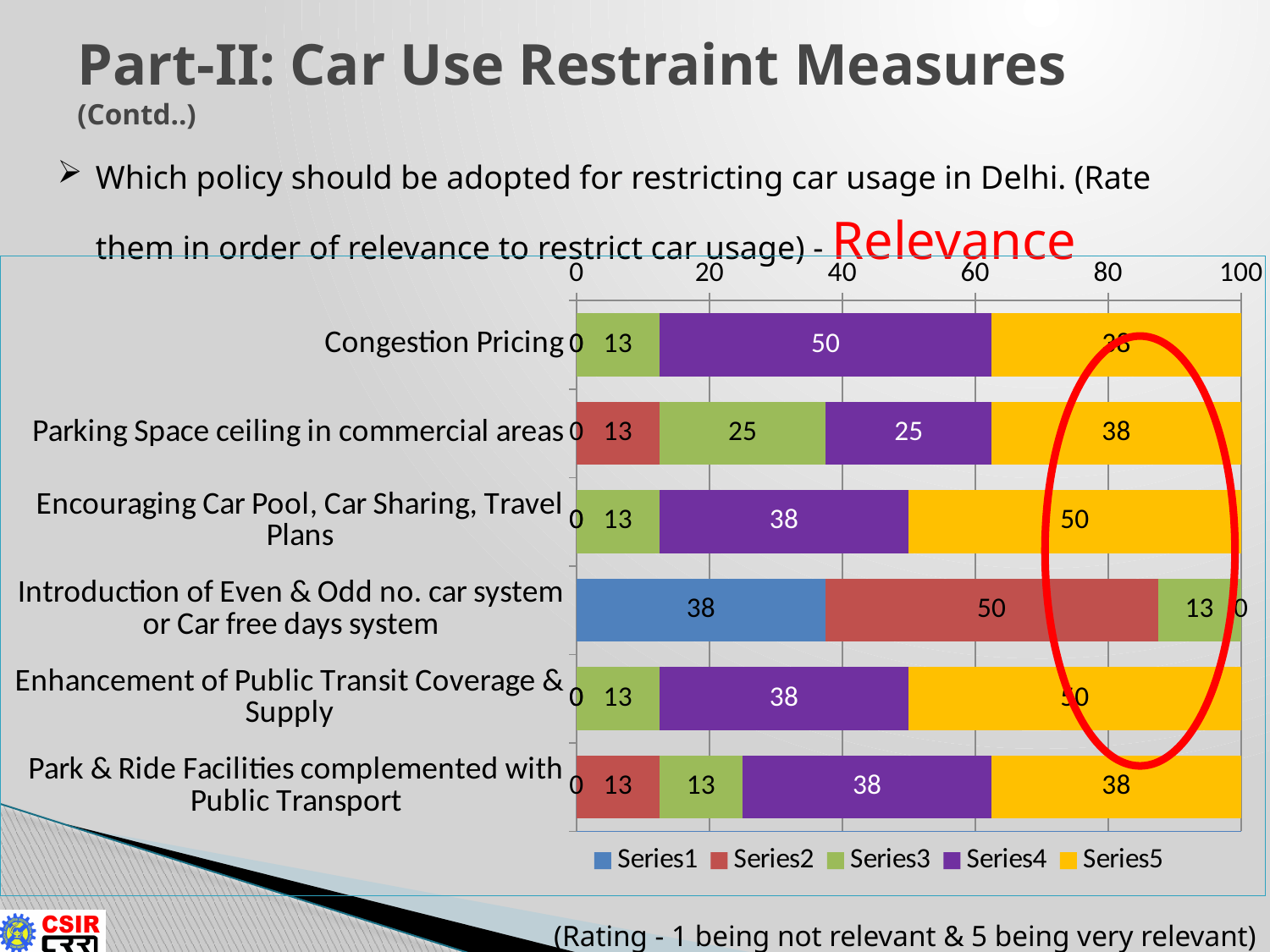
How many policy categories are plotted in the chart? 6 What is the Series5 value for Encouraging Car Pool, Car Sharing, Travel Plans? 50 What is the Series1 value for Introduction of Even & Odd no. car system or Car free days system? 38 Which category has the largest Series2 value? Introduction of Even & Odd no. car system or Car free days system What is the Series5 value for Parking Space ceiling in commercial areas? 38 What is the Series3 value for Parking Space ceiling in commercial areas? 25 What is the Series4 value for Congestion Pricing? 50 What is the Series2 value for Introduction of Even & Odd no. car system or Car free days system? 50 How many series does the legend of the chart list? 5 What kind of chart is shown on the slide? Stacked bar chart For Park & Ride Facilities complemented with Public Transport, what is the difference between the Series4 value and the Series2 value? 25